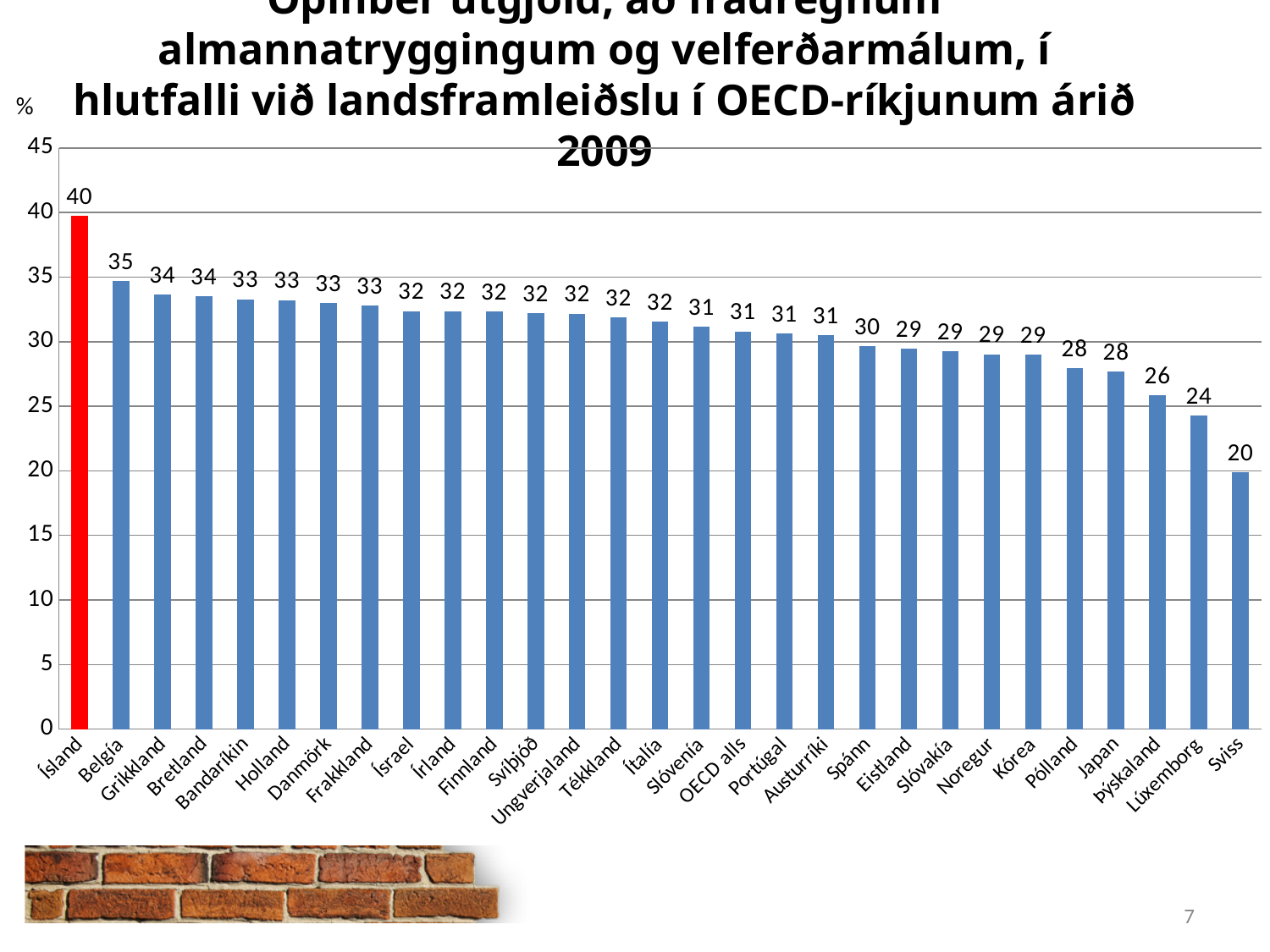
What is the value for OECD alls? 31 What kind of chart is this? bar chart What is the difference between the values for Belgía and Þýskaland? 9 What is the value for Sviss? 20 Is the value for Þýskaland greater or less than 30? less What is the value for Lúxemborg? 24 Which country has the highest value? Ísland How many countries or groups are shown on the x axis? 29 What is the difference between the values for Ísland and Sviss? 20 Which country has the lowest value? Sviss Which is larger, the value for Japan or the value for Lúxemborg? Japan What is the value for Ísland? 40